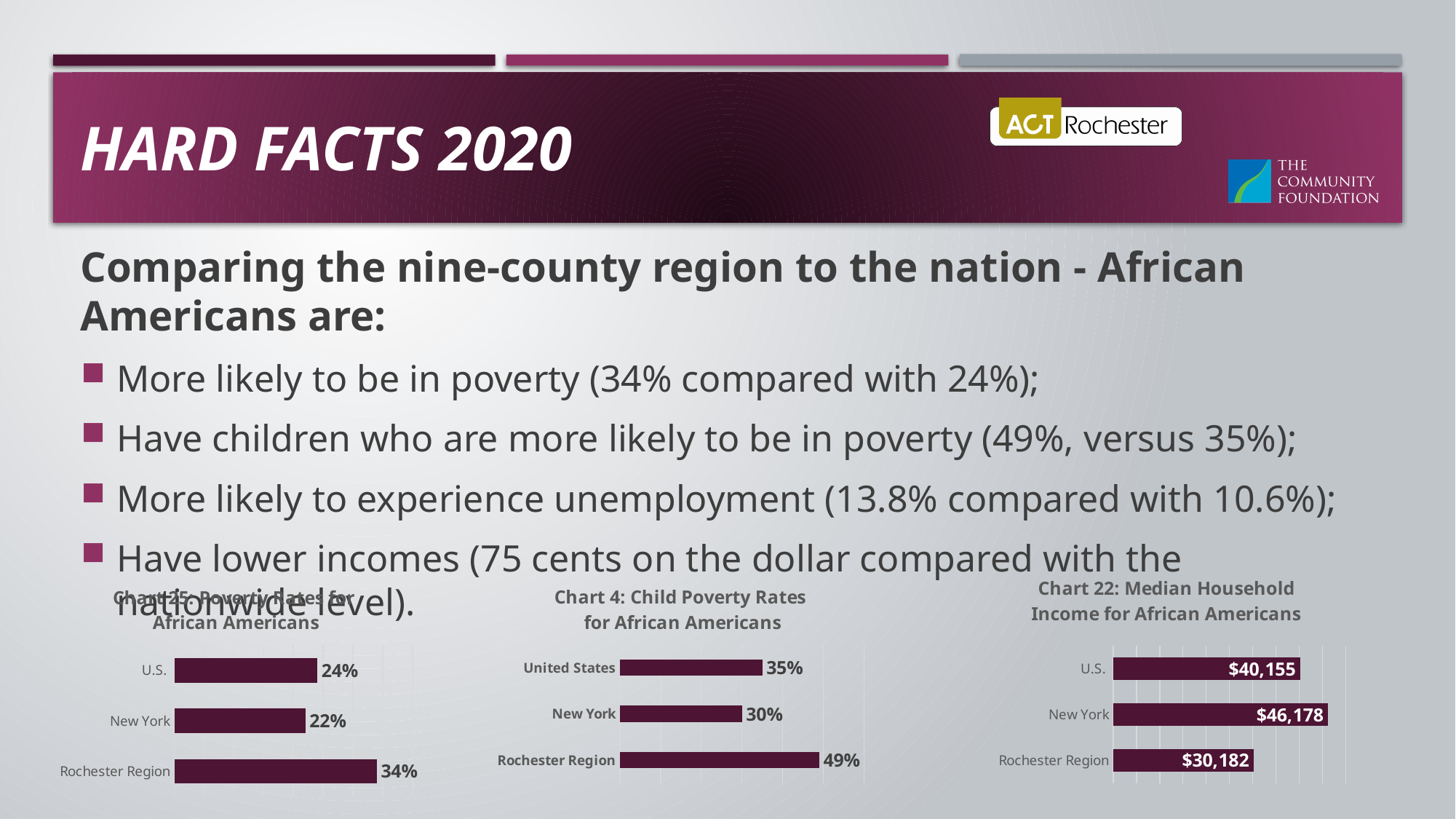
In the left chart (Poverty Rates for African Americans), what is the value for New York? 22% In the left chart (Poverty Rates for African Americans), what is the value for Rochester Region? 34% In Chart 4: Child Poverty Rates for African Americans, what is the value for United States? 35% How many categories are shown in Chart 4: Child Poverty Rates for African Americans? 3 In Chart 4: Child Poverty Rates for African Americans, what is the difference between Rochester Region and New York? 19% What type of chart is Chart 22: Median Household Income for African Americans? Bar chart In Chart 22: Median Household Income for African Americans, which is larger, U.S. or Rochester Region? U.S. In Chart 22: Median Household Income for African Americans, what is the value for New York? $46,178 In Chart 4: Child Poverty Rates for African Americans, which category has the highest value? Rochester Region In Chart 22: Median Household Income for African Americans, which category has the lowest value? Rochester Region In the left chart (Poverty Rates for African Americans), which category has the lowest value? New York In the left chart (Poverty Rates for African Americans), what is the difference between Rochester Region and U.S.? 10%